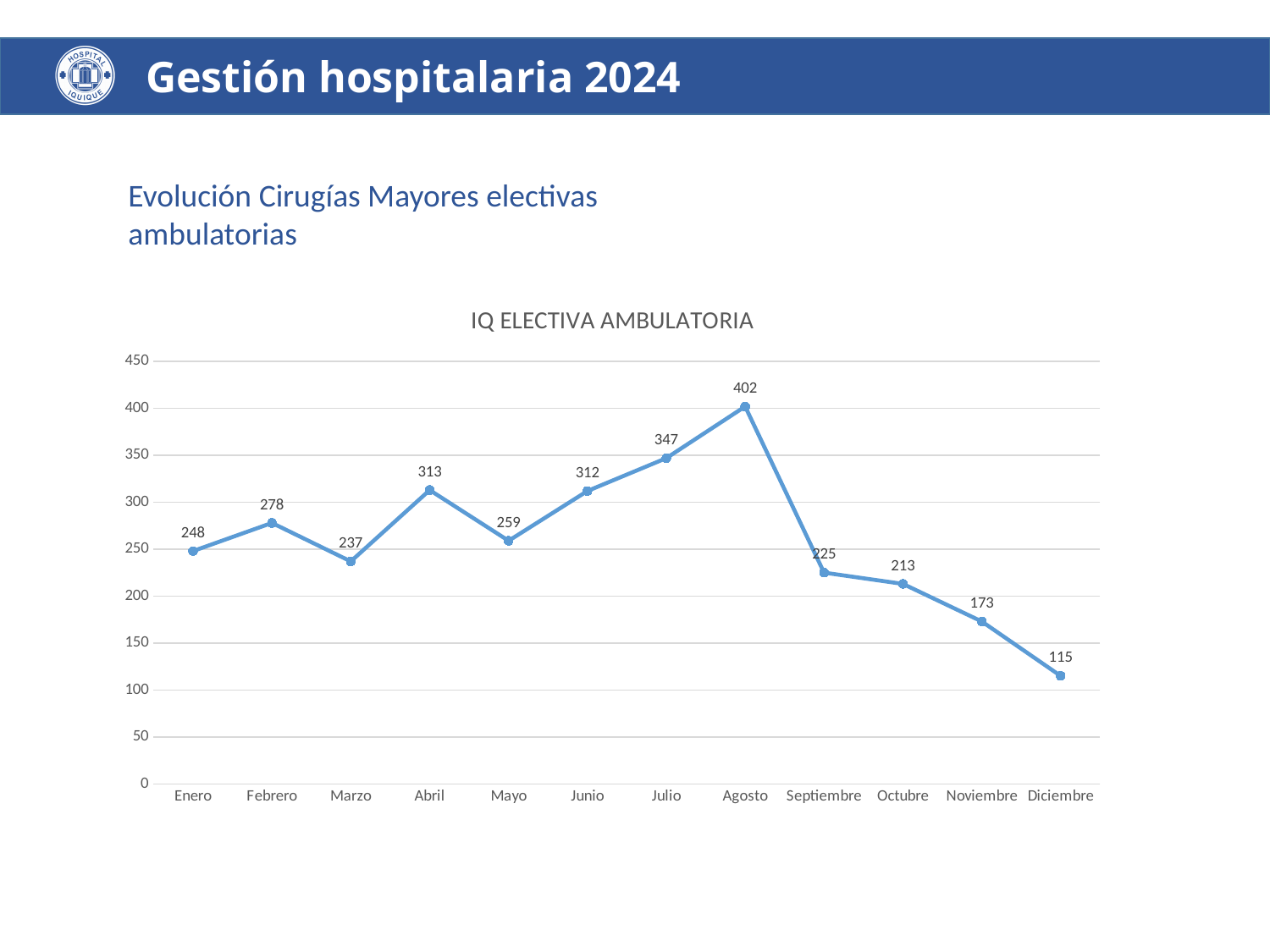
What kind of chart is shown? line chart What is the difference between the values for Agosto and Septiembre? 177 Which month has the highest value? Agosto What is the value for Agosto in the IQ ELECTIVA AMBULATORIA chart? 402 What is the value for Enero? 248 Is the value for Julio greater or less than 300? greater Do the values rise or fall from Agosto to Diciembre? fall Which month has the lowest value? Diciembre What is the title of the chart? IQ ELECTIVA AMBULATORIA Which is larger, the value for Abril or the value for Junio? Abril What is the value for Diciembre? 115 How many months are plotted on the x axis? 12